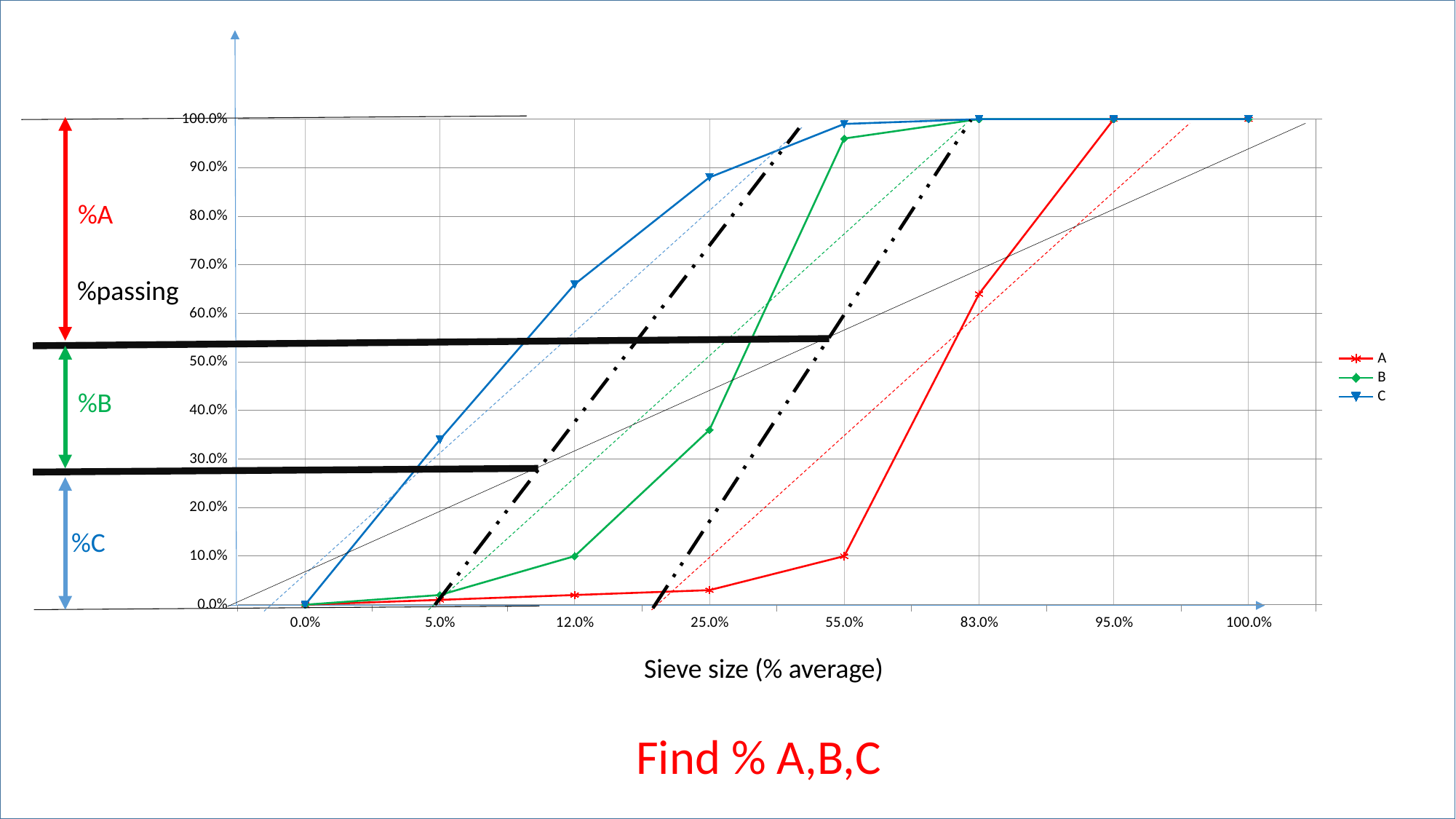
What kind of chart is shown on the slide? line chart At sieve size 12.0%, which series has the highest value? C At sieve size 55.0%, which series has the lowest value? A At sieve size 25.0%, which series has the higher value, B or C? C Is the value for series B at sieve size 25.0% greater or less than 40%? less How many sieve size categories are labelled on the x axis? 8 Is the value for series A at sieve size 83.0% greater or less than 50%? greater Is the value for series C at sieve size 12.0% greater or less than 60%? greater What is the title of the x axis? Sieve size (% average) Which colour is used for series C? blue Do the values for series A rise or fall as sieve size increases along the x axis? rise How many series does the legend list? 3